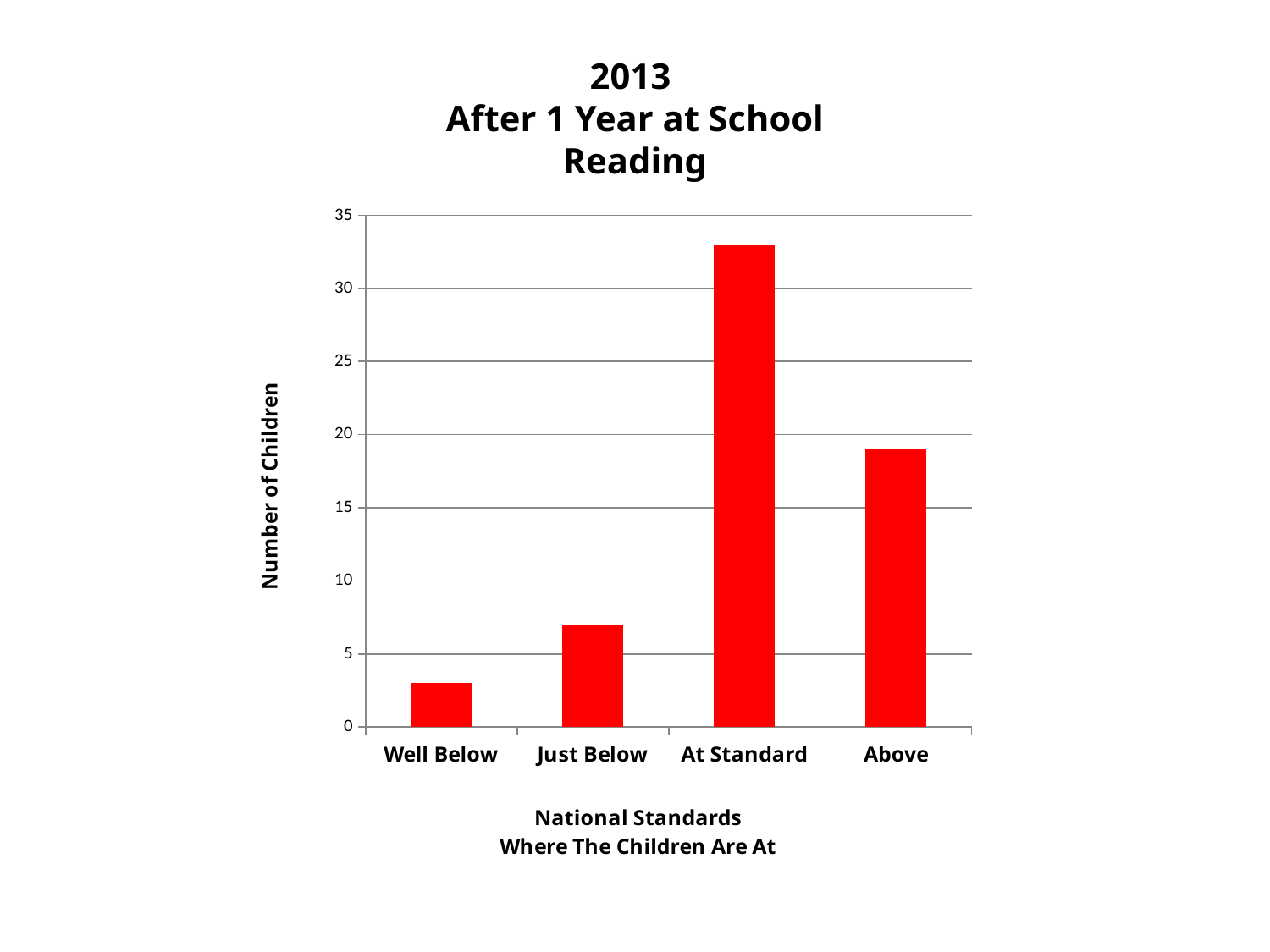
Is the value for Above greater or less than 20? less Is the value for Well Below greater or less than 5? less Is the value for At Standard greater or less than 30? greater Which has fewer children, Well Below or At Standard? Well Below Which category has the highest number of children? At Standard Which has more children, Above or Just Below? Above Which category has the lowest number of children? Well Below What year is given in the chart title? 2013 What kind of chart is shown on the slide? bar chart What is the label on the vertical axis of the chart? Number of Children How many categories are shown on the x axis of the chart? 4